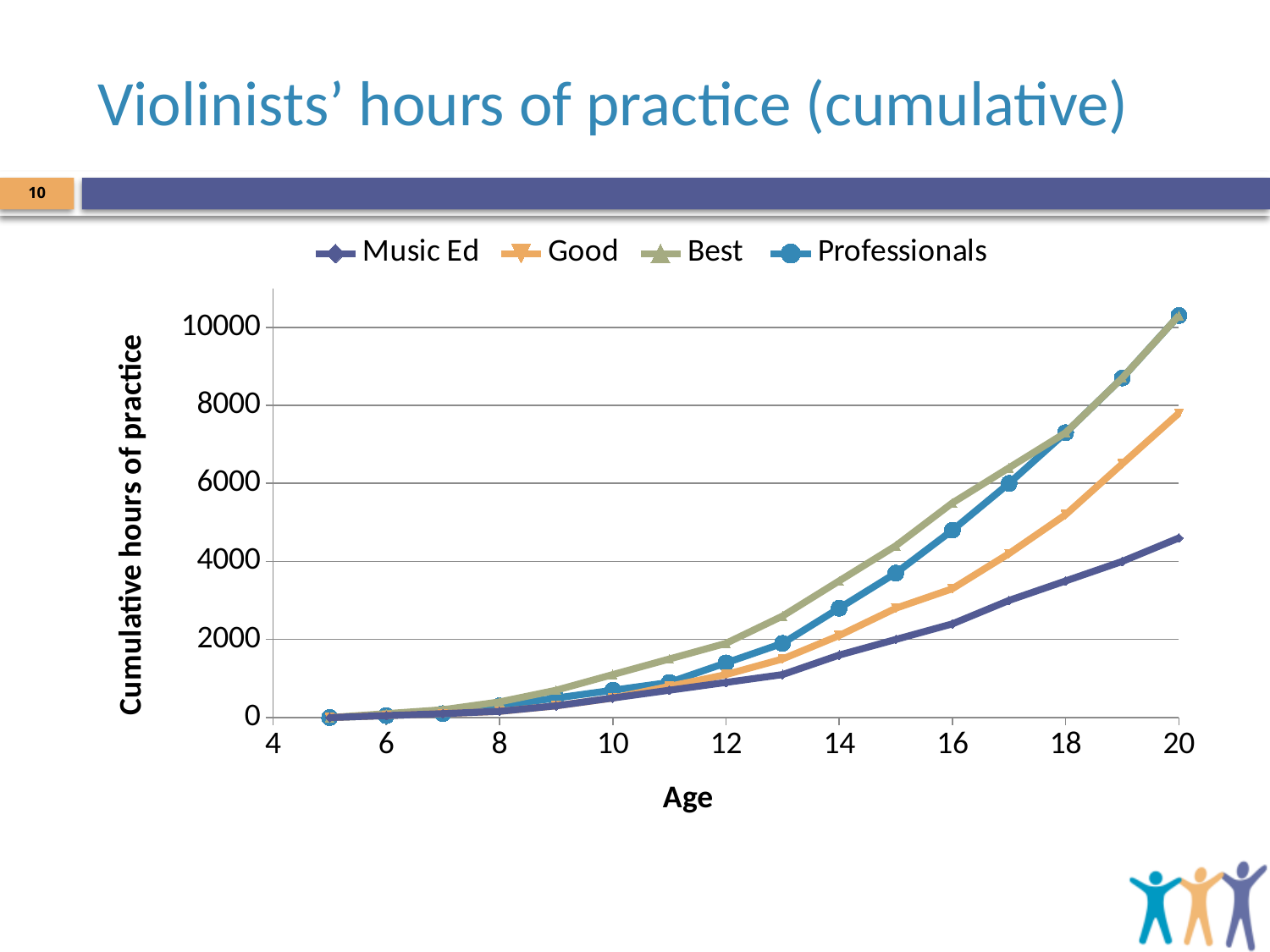
What kind of chart is shown on the slide? line chart What is the label of the vertical axis? Cumulative hours of practice What is the title of the chart? Violinists' hours of practice (cumulative) How many series does the legend list? 4 Is the value for Professionals at age 16 greater or less than 4000? greater Do the cumulative hours for Professionals rise or fall as age increases? rise Is the value for Music Ed at age 20 greater or less than 4000? greater At age 16, which is larger: the value for Best or the value for Professionals? Best Is the value for Best at age 16 greater or less than 6000? less Which series has the lowest cumulative hours of practice at age 20? Music Ed At age 20, which is larger: the value for Good or the value for Music Ed? Good